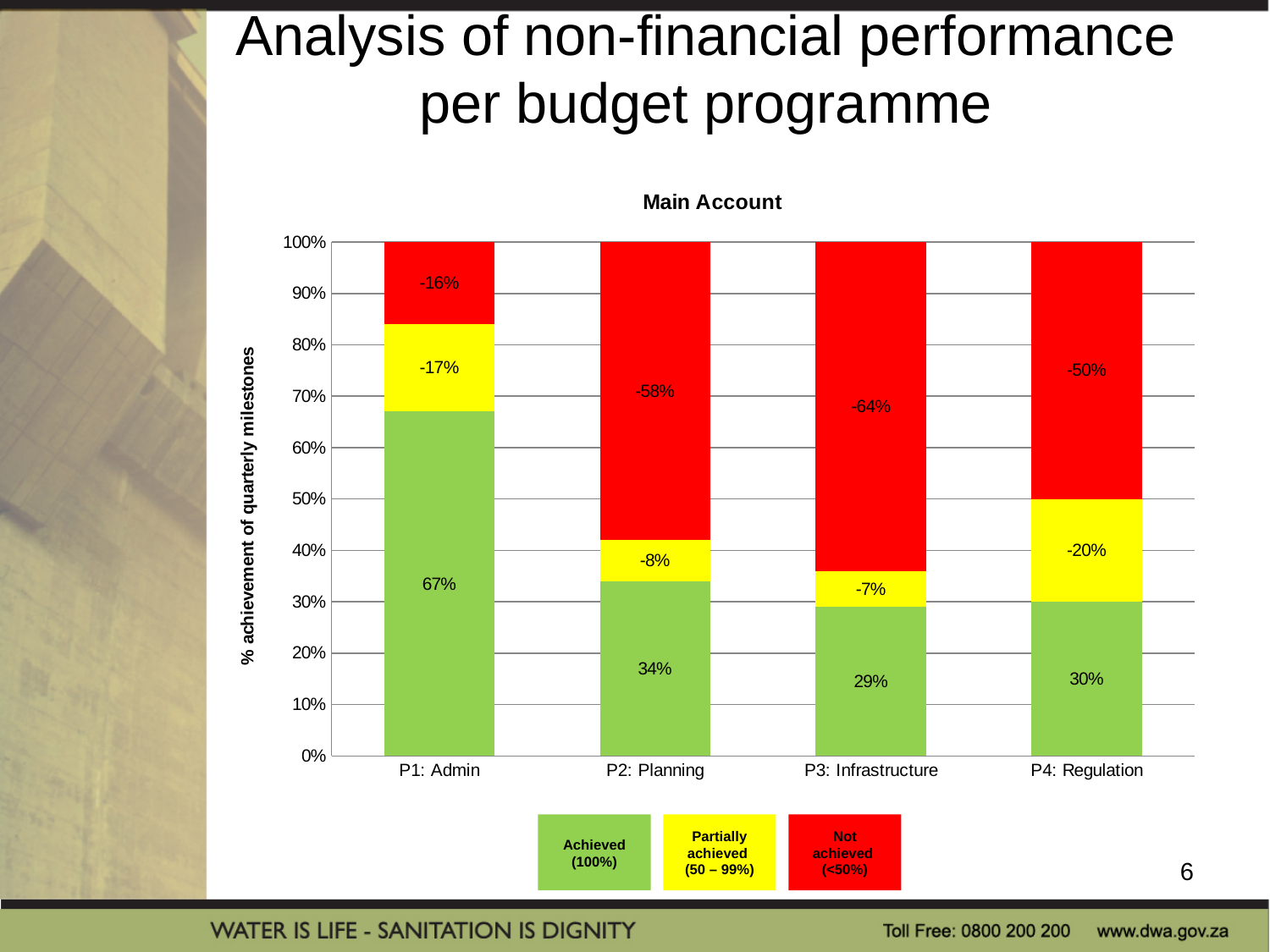
What kind of chart is shown on the slide? Stacked bar chart Which budget programme has the highest Achieved (100%) value? P1: Admin What is the title of the chart? Main Account Which has a larger Achieved (100%) value, P4: Regulation or P3: Infrastructure? P4: Regulation How many series does the legend list? 3 How many budget programmes are shown on the x axis? 4 What is the Achieved (100%) value for P1: Admin? 67% Which budget programme has the lowest Achieved (100%) value? P3: Infrastructure What label is printed on the Not achieved (<50%) segment for P3: Infrastructure? -64% What is the difference between the Achieved (100%) values for P1: Admin and P2: Planning? 33% What is the Achieved (100%) value for P2: Planning? 34% What label is printed on the Partially achieved (50 – 99%) segment for P4: Regulation? -20%